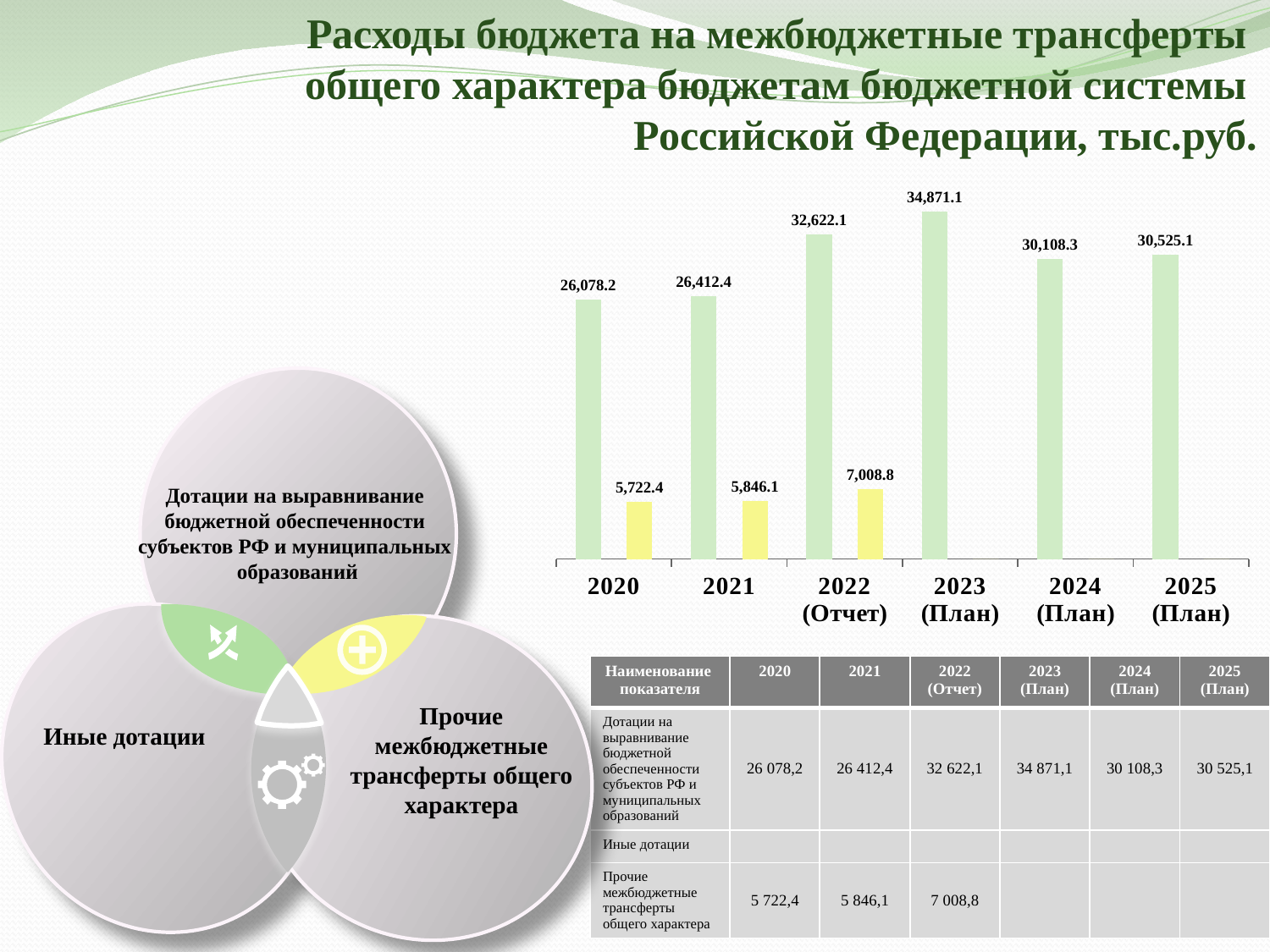
What is the difference between the yellow bar values for 2022 (Отчет) and 2021? 1,162.7 What is the value of the green bar for 2020? 26,078.2 What is the value of the yellow bar for 2022 (Отчет)? 7,008.8 Which is larger, the green bar for 2024 (План) or the green bar for 2025 (План)? 2025 (План) For how many years is a yellow bar shown? 3 Which year has the highest green bar? 2023 (План) What type of chart is shown on the slide? bar chart How many years are shown on the x axis of the chart? 6 What is the value of the green bar for 2025 (План)? 30,525.1 Do the green bar values rise or fall from 2020 to 2023 (План)? rise What is the difference between the green bar values for 2023 (План) and 2024 (План)? 4,762.8 Which year has the lowest green bar? 2020